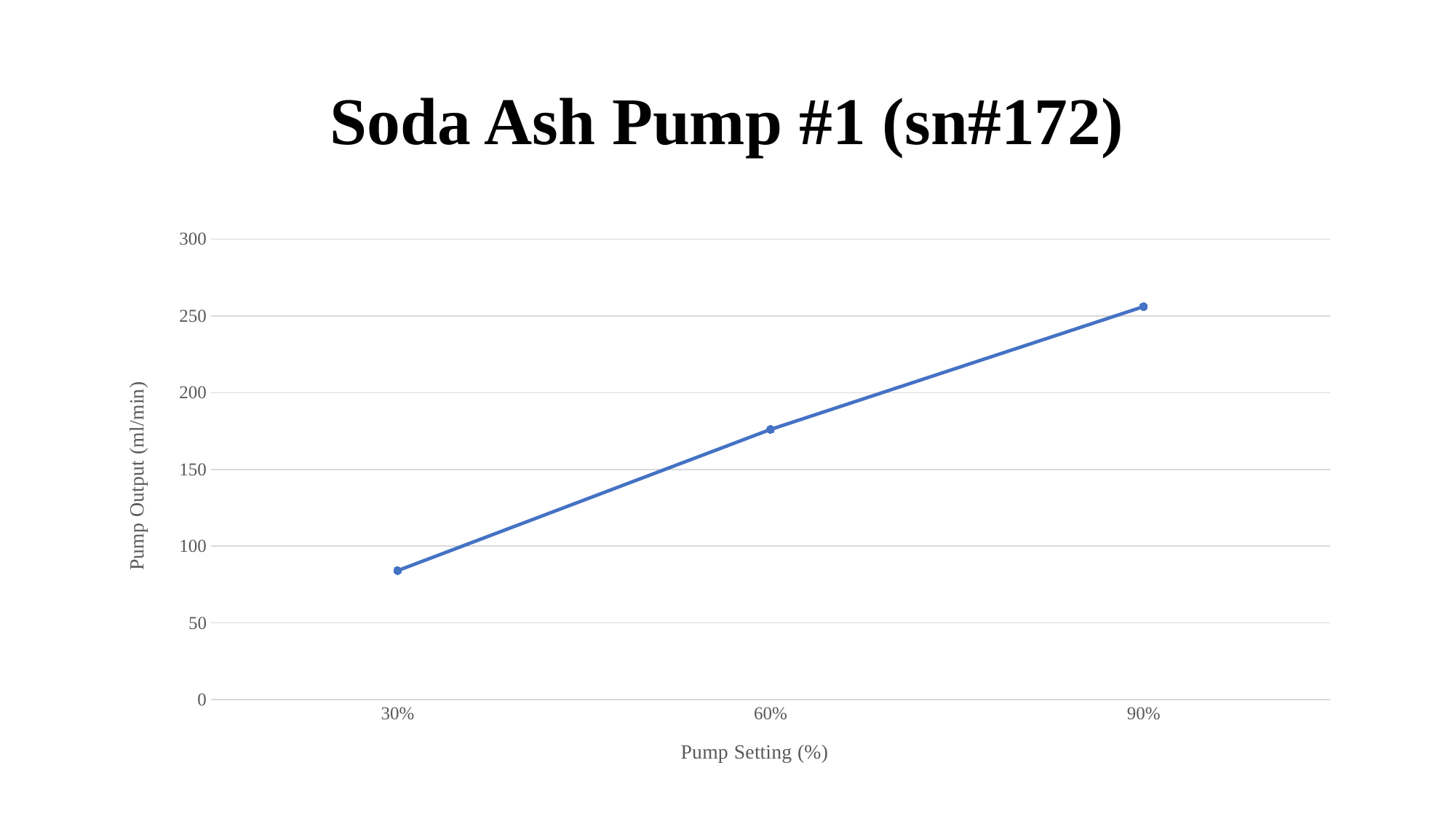
What kind of chart is shown on the slide? line chart Is the pump output at the 30% setting greater or less than 100? less Is the pump output at the 60% setting greater or less than 150? greater Which has a larger pump output, the 30% setting or the 60% setting? 60% What is the title of the chart? Soda Ash Pump #1 (sn#172) Which pump setting has the highest pump output? 90% Does the pump output rise or fall as the pump setting increases from 30% to 90%? rise Is the pump output at the 60% setting greater or less than 200? less How many data points are plotted on the line? 3 What is the label of the y axis? Pump Output (ml/min) Which pump setting has the lowest pump output? 30%